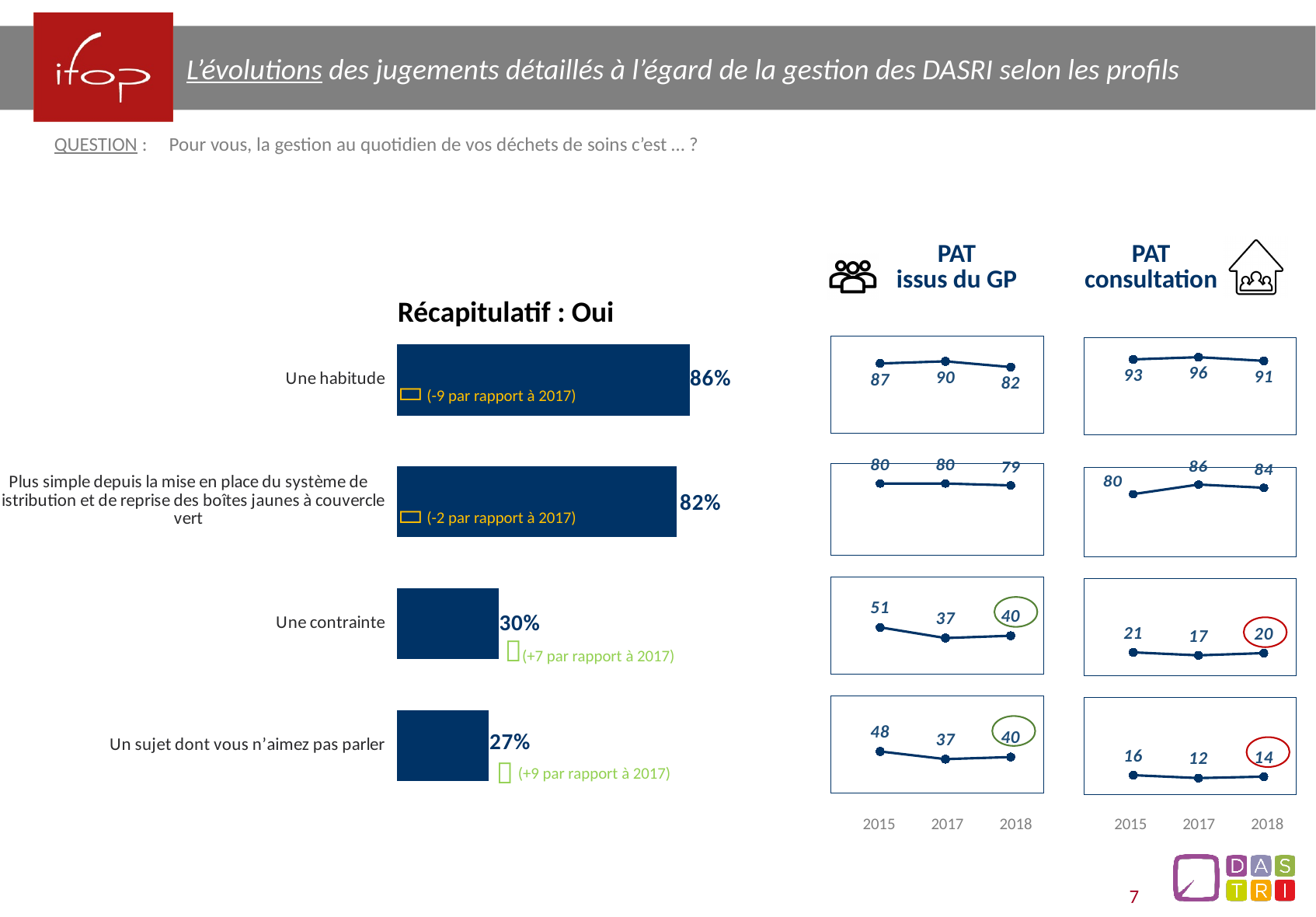
In the bar chart 'Récapitulatif : Oui', which category has the lowest value? Un sujet dont vous n'aimez pas parler In the bar chart 'Récapitulatif : Oui', what is the value for 'Une habitude'? 86% In the 'PAT issus du GP' line chart for 'Un sujet dont vous n'aimez pas parler', what is the difference between 2015 and 2017? 11 In the bar chart 'Récapitulatif : Oui', what is the difference between 'Une habitude' and 'Une contrainte'? 56% In the bar chart 'Récapitulatif : Oui', which category has the highest value? Une habitude In the bar chart 'Récapitulatif : Oui', how many categories are shown? 4 In the bar chart 'Récapitulatif : Oui', what is the value for 'Un sujet dont vous n'aimez pas parler'? 27% In the 'PAT issus du GP' line chart for 'Une habitude', what is the value for 2018? 82 In the 'PAT issus du GP' line chart for 'Une contrainte', which year has the highest value? 2015 In the 'PAT consultation' line chart for 'Une habitude', what is the value for 2017? 96 In the 'PAT consultation' line chart for 'Un sujet dont vous n'aimez pas parler', is the value for 2018 larger or smaller than the value for 2017? Larger What kind of chart is 'Récapitulatif : Oui'? Bar chart